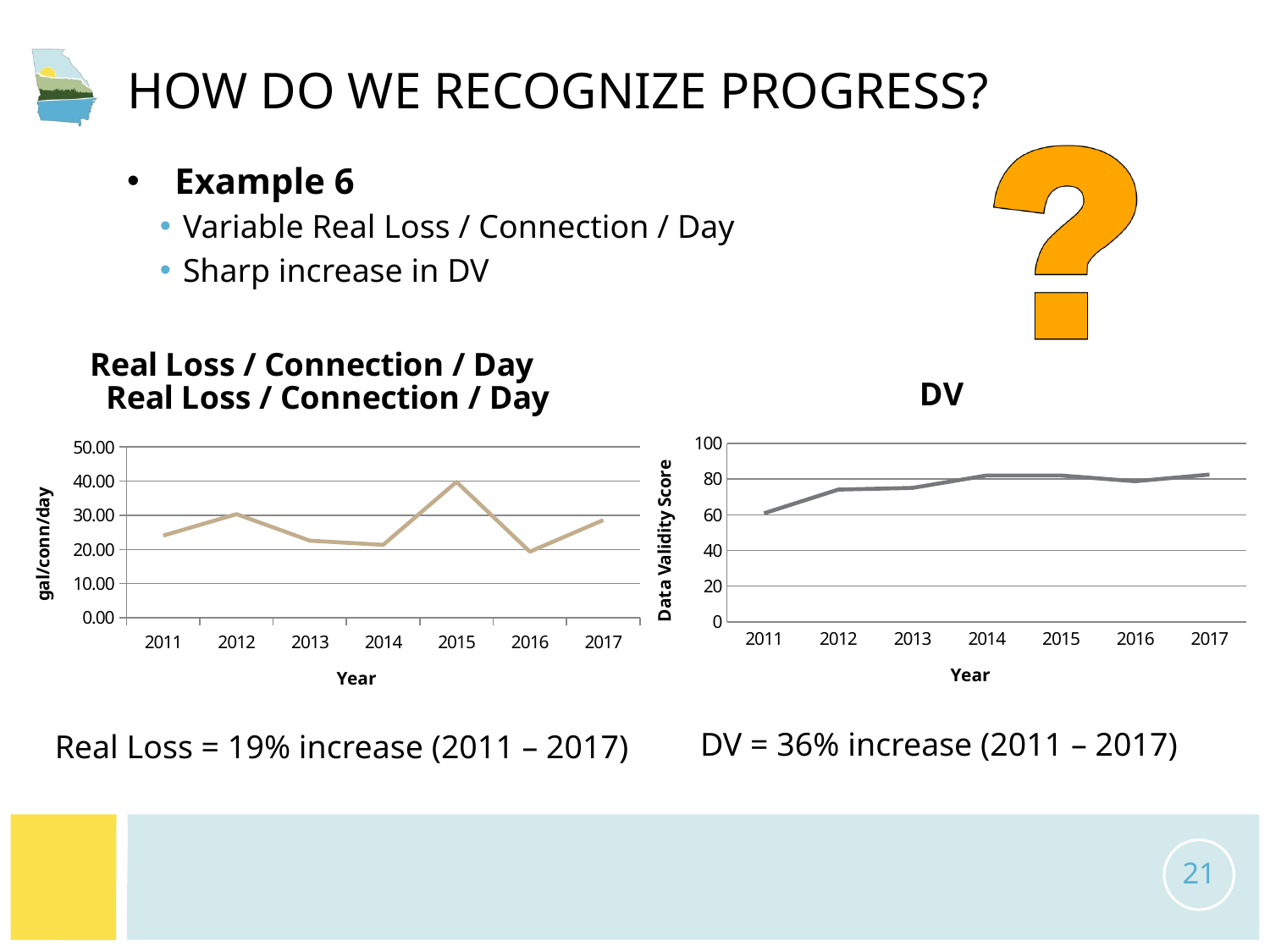
What is the y-axis label of the 'DV' chart? Data Validity Score How many years are plotted on the x axis of the 'DV' chart? 7 What kind of chart is the 'DV' chart? line chart In the 'DV' chart, do the values generally rise or fall from 2011 to 2017? rise In the 'DV' chart, is the value for 2011 greater or less than 70? less What kind of chart is the 'Real Loss / Connection / Day' chart? line chart In the 'Real Loss / Connection / Day' chart, which year has the highest value? 2015 In the 'Real Loss / Connection / Day' chart, is the value for 2011 greater or less than 20.00? greater In the 'DV' chart, is the value for 2012 greater or less than 70? greater In the 'DV' chart, which year has the lowest value? 2011 In the 'Real Loss / Connection / Day' chart, which year has the larger value, 2012 or 2013? 2012